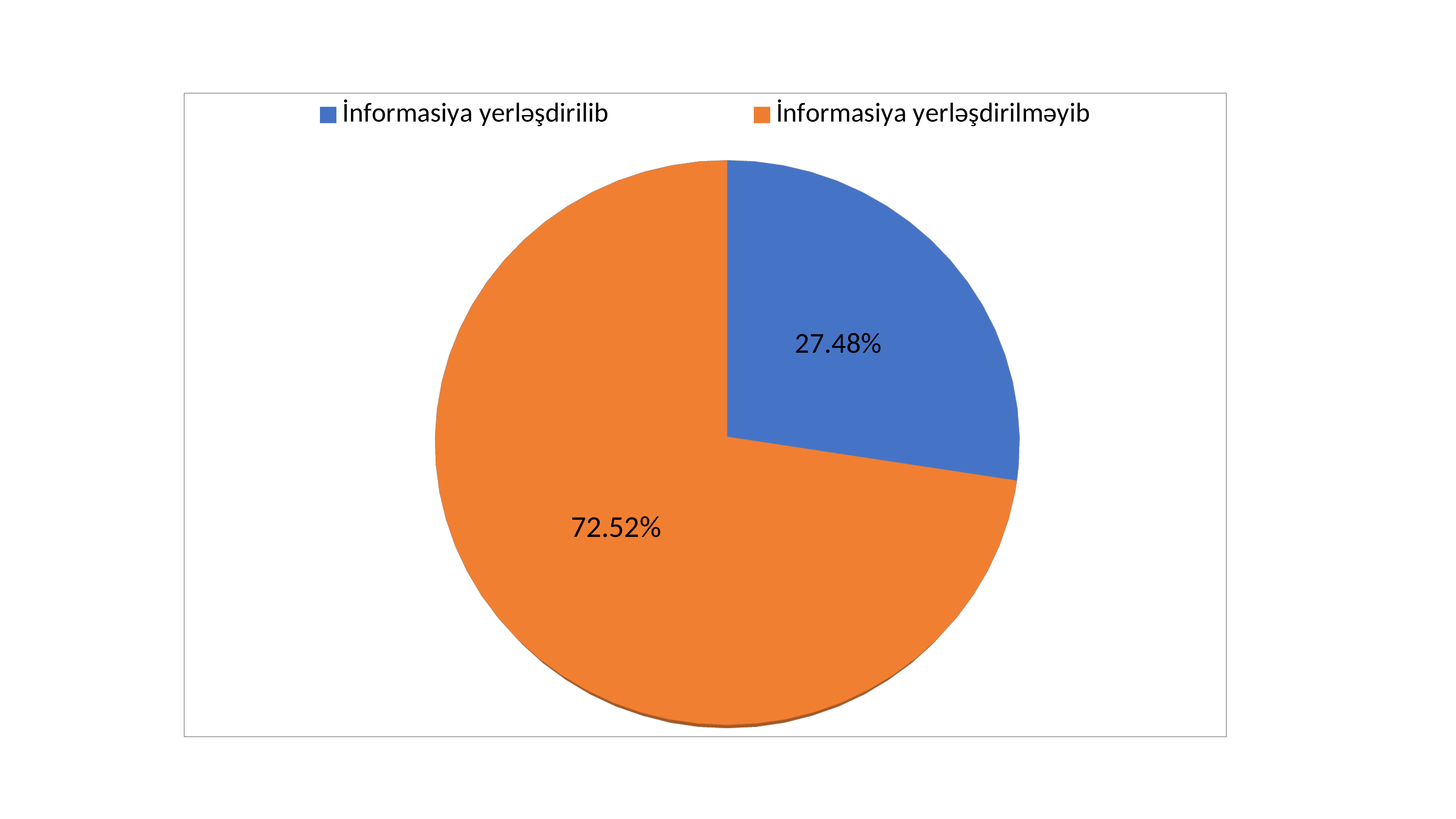
Which is larger, İnformasiya yerləşdirilib or İnformasiya yerləşdirilməyib? İnformasiya yerləşdirilməyib What share of the pie does İnformasiya yerləşdirilib represent? 27.48% What kind of chart is shown on the slide? pie chart What is the value for İnformasiya yerləşdirilib? 27.48% How many slices does the pie chart have? 2 What is the difference between the values for İnformasiya yerləşdirilməyib and İnformasiya yerləşdirilib? 45.04% What colour is the slice for İnformasiya yerləşdirilməyib? orange Which category has the smallest slice? İnformasiya yerləşdirilib How many entries does the legend list? 2 What is the value for İnformasiya yerləşdirilməyib? 72.52% Which category has the largest slice? İnformasiya yerləşdirilməyib What colour is the slice for İnformasiya yerləşdirilib? blue